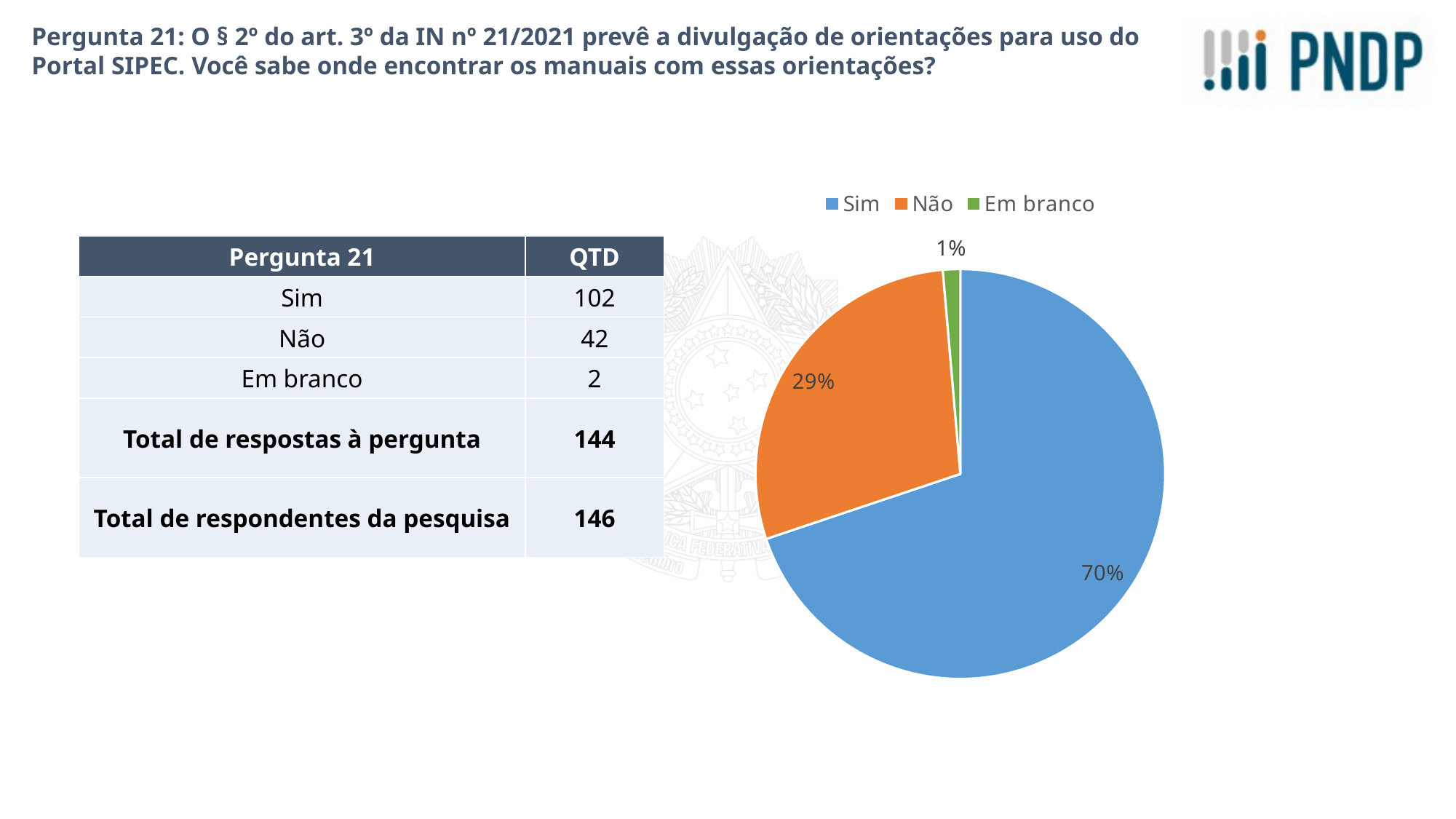
What share of the pie does the Sim slice represent? 70% How many entries does the legend of the pie chart list? 3 Which slice of the pie chart is the smallest? Em branco Which slice of the pie chart is the largest? Sim What share of the pie does the Em branco slice represent? 1% How many slices does the pie chart have? 3 What kind of chart is shown on the slide? pie chart What colour is the Não slice in the pie chart? orange What is the difference in percentage points between the Sim slice and the Não slice? 41 What share of the pie does the Não slice represent? 29% Which legend entry is shown in green? Em branco Which slice is larger, Não or Em branco? Não